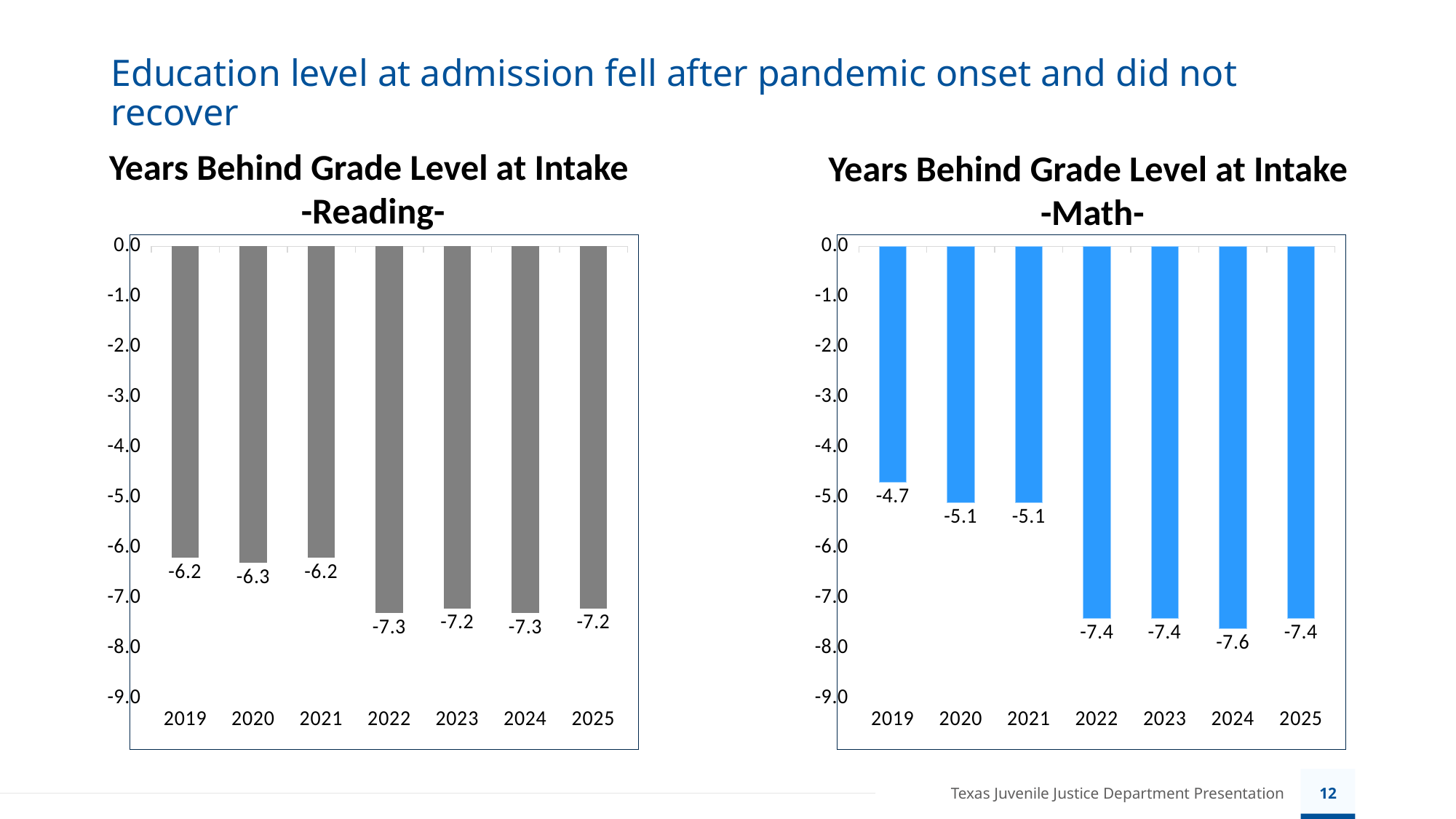
In the 'Years Behind Grade Level at Intake -Reading-' chart, which is larger, the value for 2019 or the value for 2023? 2019 In the 'Years Behind Grade Level at Intake -Math-' chart, what is the value for 2019? -4.7 What kind of chart is the 'Years Behind Grade Level at Intake -Reading-' chart? Bar chart In the 'Years Behind Grade Level at Intake -Math-' chart, what is the difference between the 2019 value and the 2022 value? 2.7 In the 'Years Behind Grade Level at Intake -Reading-' chart, what is the difference between the 2021 value and the 2022 value? 1.1 In the 'Years Behind Grade Level at Intake -Math-' chart, which year has the lowest value? 2024 How many years are shown on the x axis of the 'Years Behind Grade Level at Intake -Math-' chart? 7 What colour are the bars in the 'Years Behind Grade Level at Intake -Math-' chart? Blue In the 'Years Behind Grade Level at Intake -Math-' chart, what is the value for 2024? -7.6 In the 'Years Behind Grade Level at Intake -Reading-' chart, what is the value for 2022? -7.3 In the 'Years Behind Grade Level at Intake -Reading-' chart, what is the value for 2020? -6.3 In the 'Years Behind Grade Level at Intake -Math-' chart, which year has the highest value? 2019